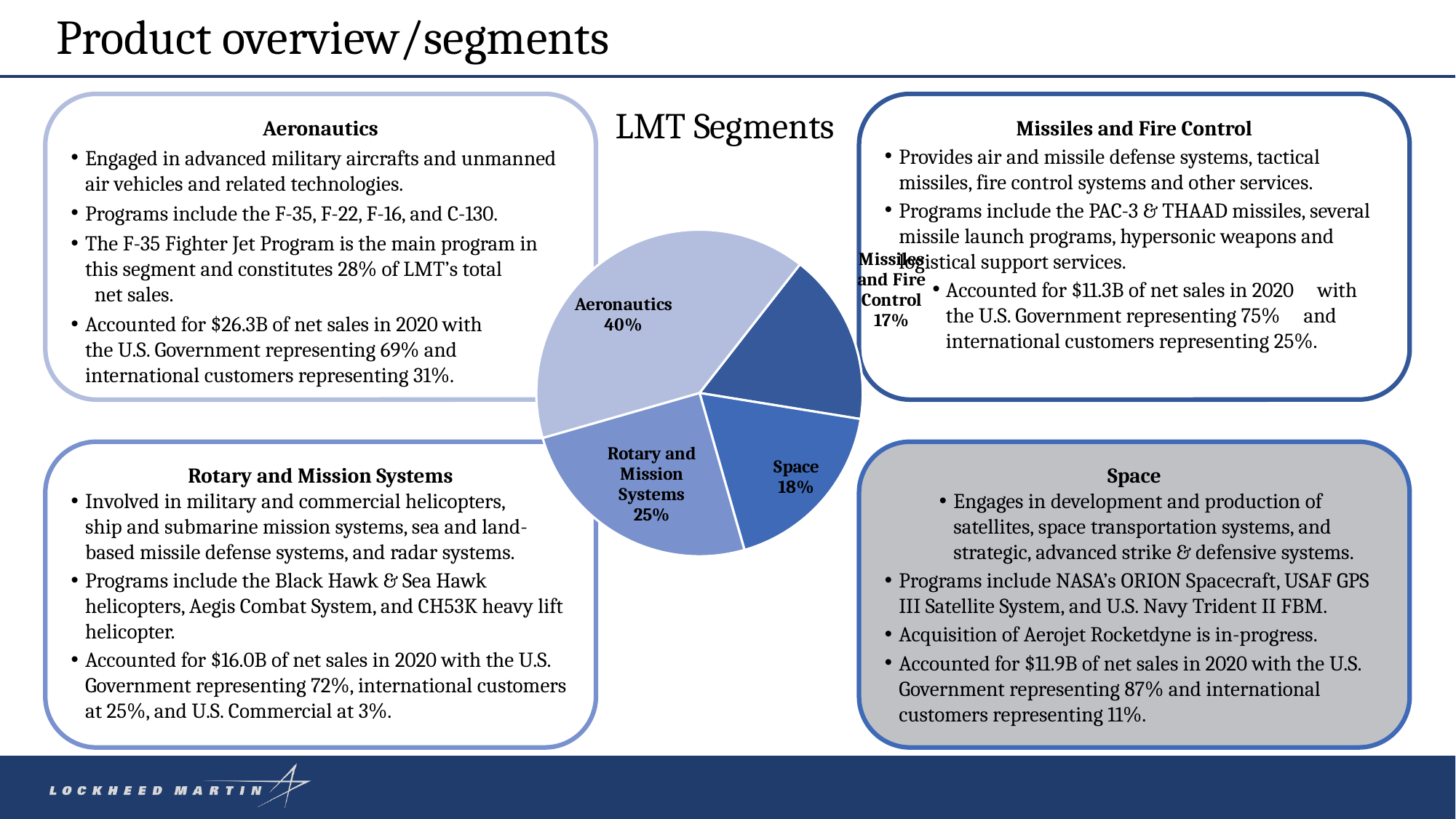
What kind of chart is shown on the slide? pie chart What share of the pie does Rotary and Mission Systems represent? 25% What is the title of the chart? LMT Segments Which segment has the largest slice of the pie? Aeronautics Which is larger, the Space slice or the Rotary and Mission Systems slice? Rotary and Mission Systems What share of the pie does Missiles and Fire Control represent? 17% What share of the pie does Space represent? 18% How many segments are shown in the pie chart? 4 What is the difference in percentage points between Space and Missiles and Fire Control? 1 What share of the pie does Aeronautics represent? 40% What is the difference in percentage points between Aeronautics and Rotary and Mission Systems? 15 Which segment has the smallest slice of the pie? Missiles and Fire Control